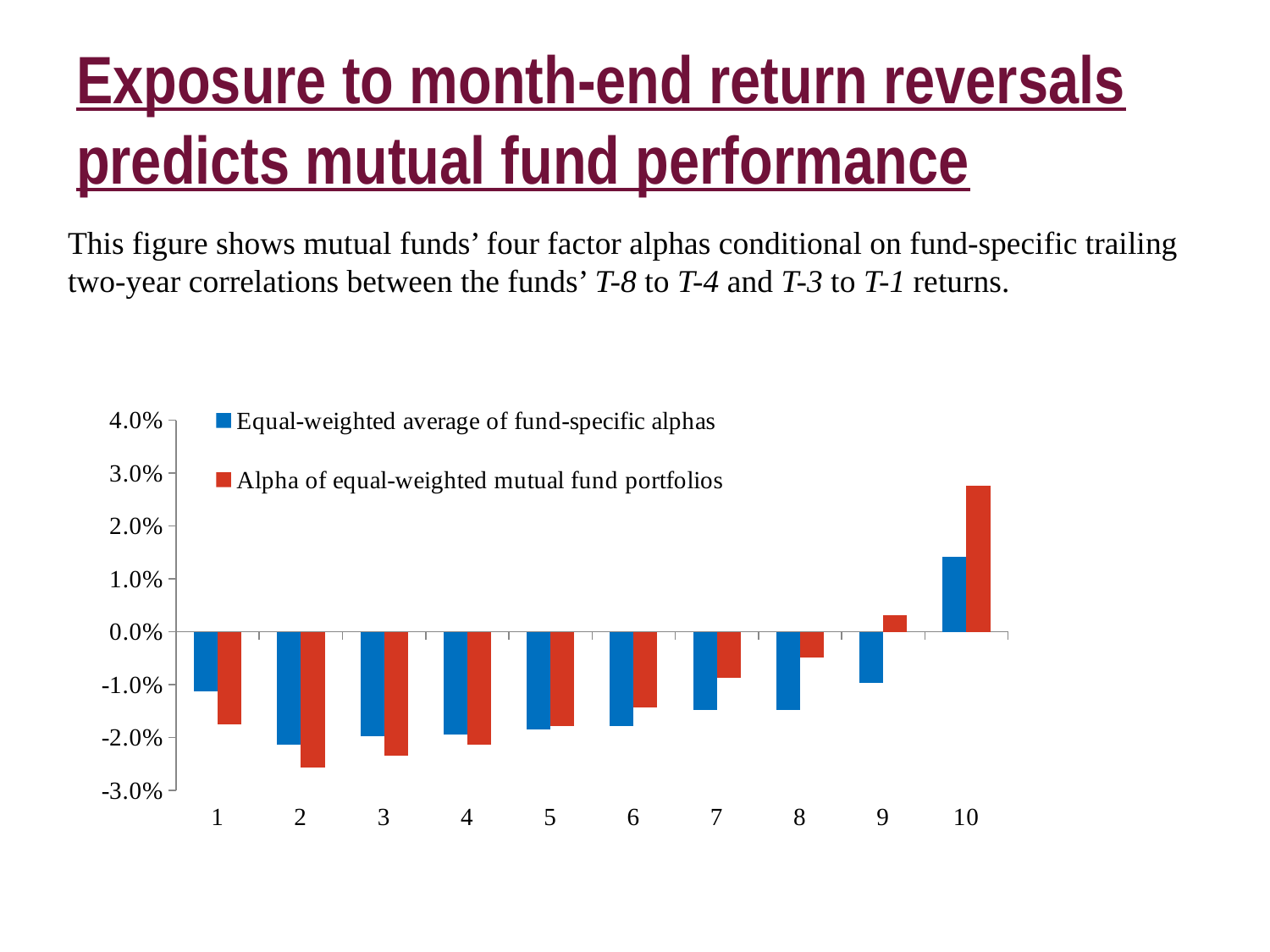
In category 10, which series has the larger value: 'Equal-weighted average of fund-specific alphas' or 'Alpha of equal-weighted mutual fund portfolios'? Alpha of equal-weighted mutual fund portfolios Which category has the highest value for 'Equal-weighted average of fund-specific alphas'? 10 Is the value for 'Alpha of equal-weighted mutual fund portfolios' in category 10 greater or less than 2.0%? greater Which category has the lowest value for 'Alpha of equal-weighted mutual fund portfolios'? 2 How many series does the legend list? 2 Is the value for 'Equal-weighted average of fund-specific alphas' in category 1 greater or less than -2.0%? greater Is the value for 'Alpha of equal-weighted mutual fund portfolios' in category 2 greater or less than -2.0%? less How many categories are shown on the x axis? 10 What colour represents 'Alpha of equal-weighted mutual fund portfolios' in the legend? red Which category has the highest value for 'Alpha of equal-weighted mutual fund portfolios'? 10 In category 1, which series has the larger value: 'Equal-weighted average of fund-specific alphas' or 'Alpha of equal-weighted mutual fund portfolios'? Equal-weighted average of fund-specific alphas What kind of chart is shown on the slide? bar chart